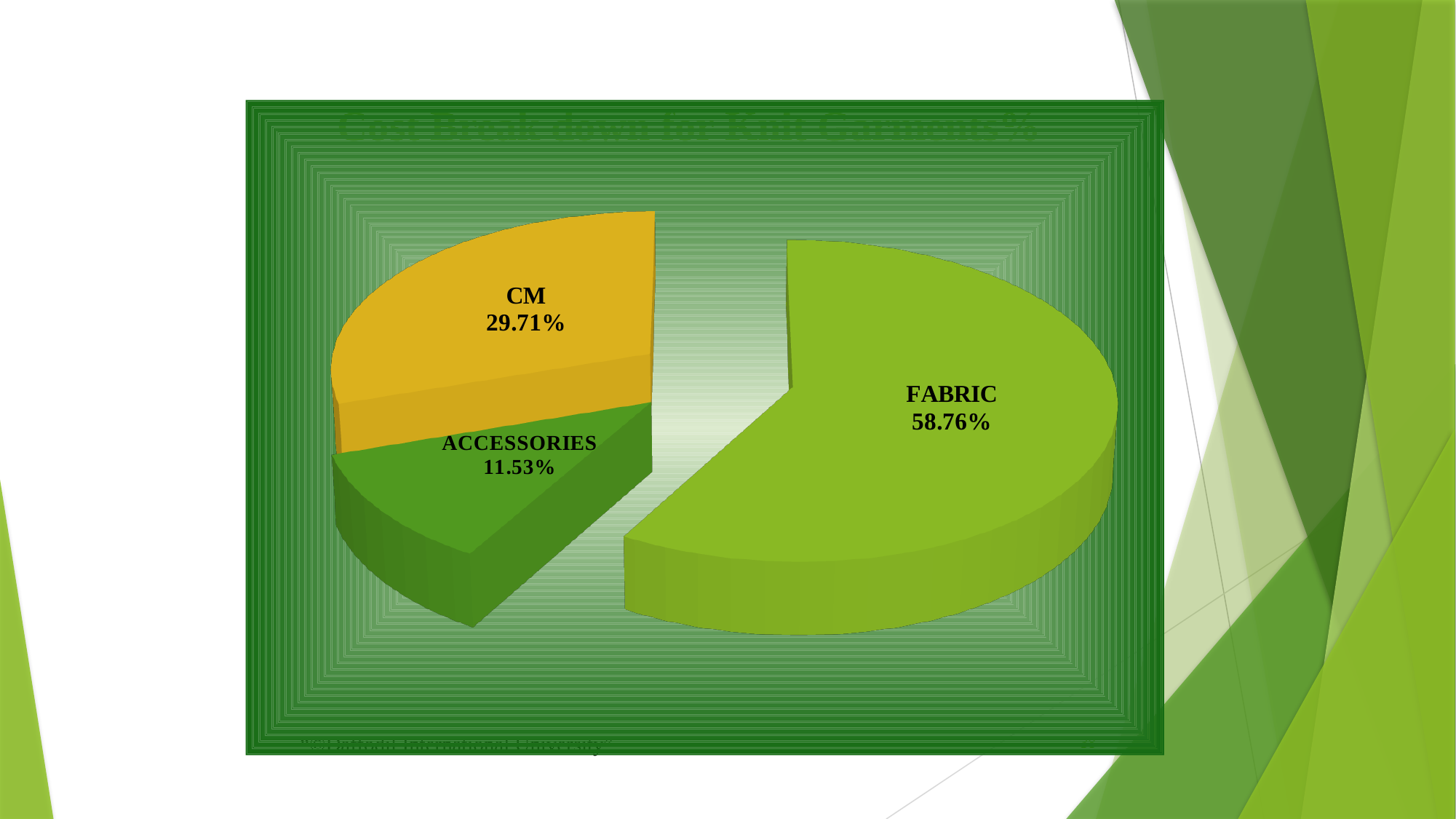
What share of the pie does FABRIC represent? 58.76% Which is larger, CM or ACCESSORIES? CM What is the value shown for CM? 29.71% What is the difference between the CM and ACCESSORIES values? 18.18% What is the value shown for FABRIC? 58.76% What colour is the FABRIC slice? light green What is the value shown for ACCESSORIES? 11.53% What is the difference between the FABRIC and CM values? 29.05% How many slices does the pie chart have? 3 What kind of chart is shown on the slide? pie chart Which slice of the pie chart is the largest? FABRIC Which slice of the pie chart is the smallest? ACCESSORIES